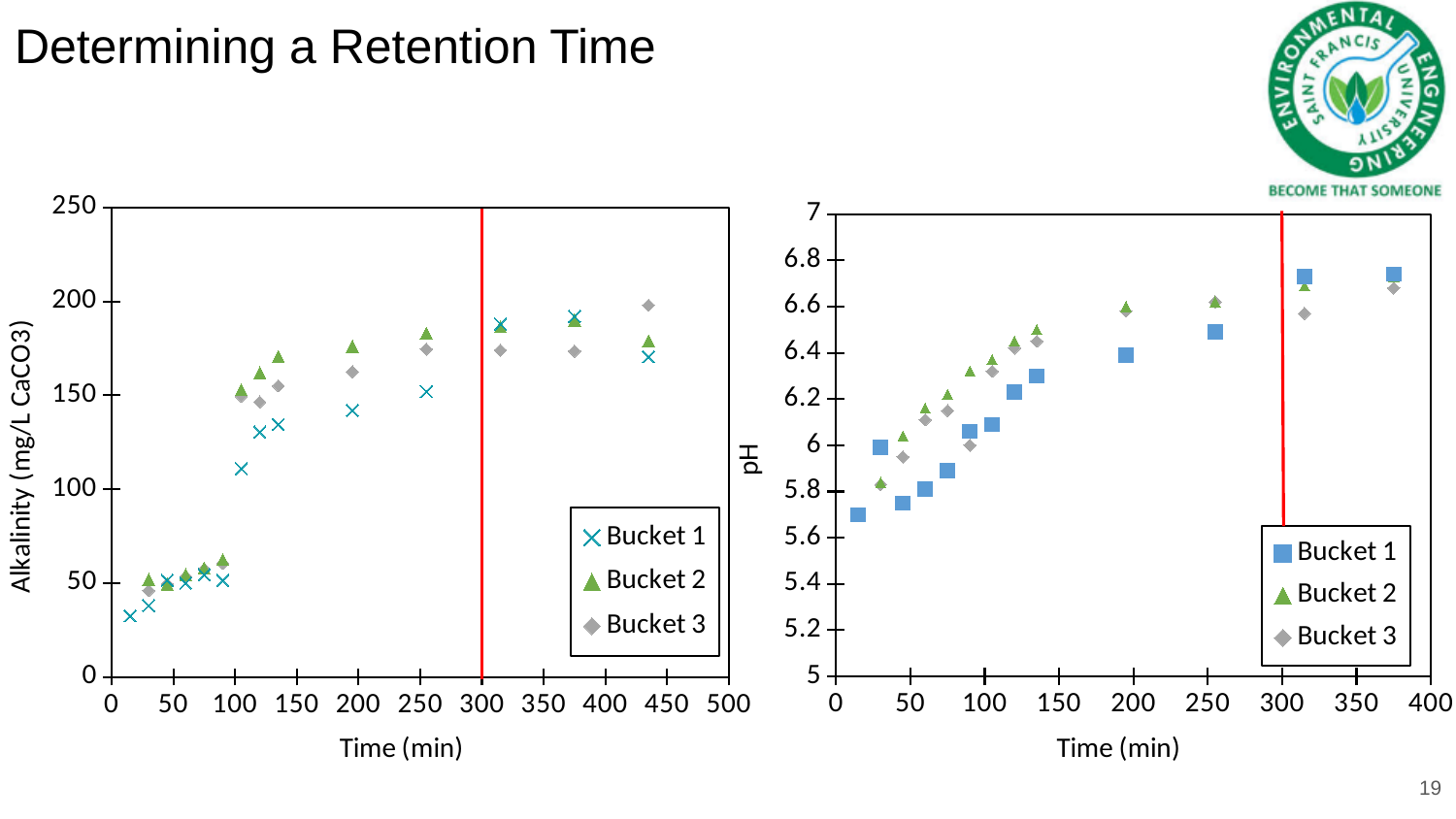
In the right chart, is the pH value for Bucket 1 at about 375 min greater or less than 6.6? greater In the right chart, is the pH value for Bucket 1 at about 15 min greater or less than 6? less In the right chart, what is the label of the x axis? Time (min) In the left chart, is the alkalinity value for Bucket 1 at about 15 min greater or less than 50? less What kind of chart is the left chart (Alkalinity vs Time)? scatter chart How many series does the legend of the right chart (pH vs Time) list? 3 In the left chart, at about 255 min, which series has the higher alkalinity, Bucket 1 or Bucket 2? Bucket 2 In the right chart, at about 75 min, which series has the higher pH, Bucket 1 or Bucket 2? Bucket 2 In the left chart, do the alkalinity values for Bucket 2 generally rise or fall as time increases? rise In the left chart, what is the label of the y axis? Alkalinity (mg/L CaCO3) In the right chart, do the pH values for Bucket 1 generally rise or fall as time increases? rise